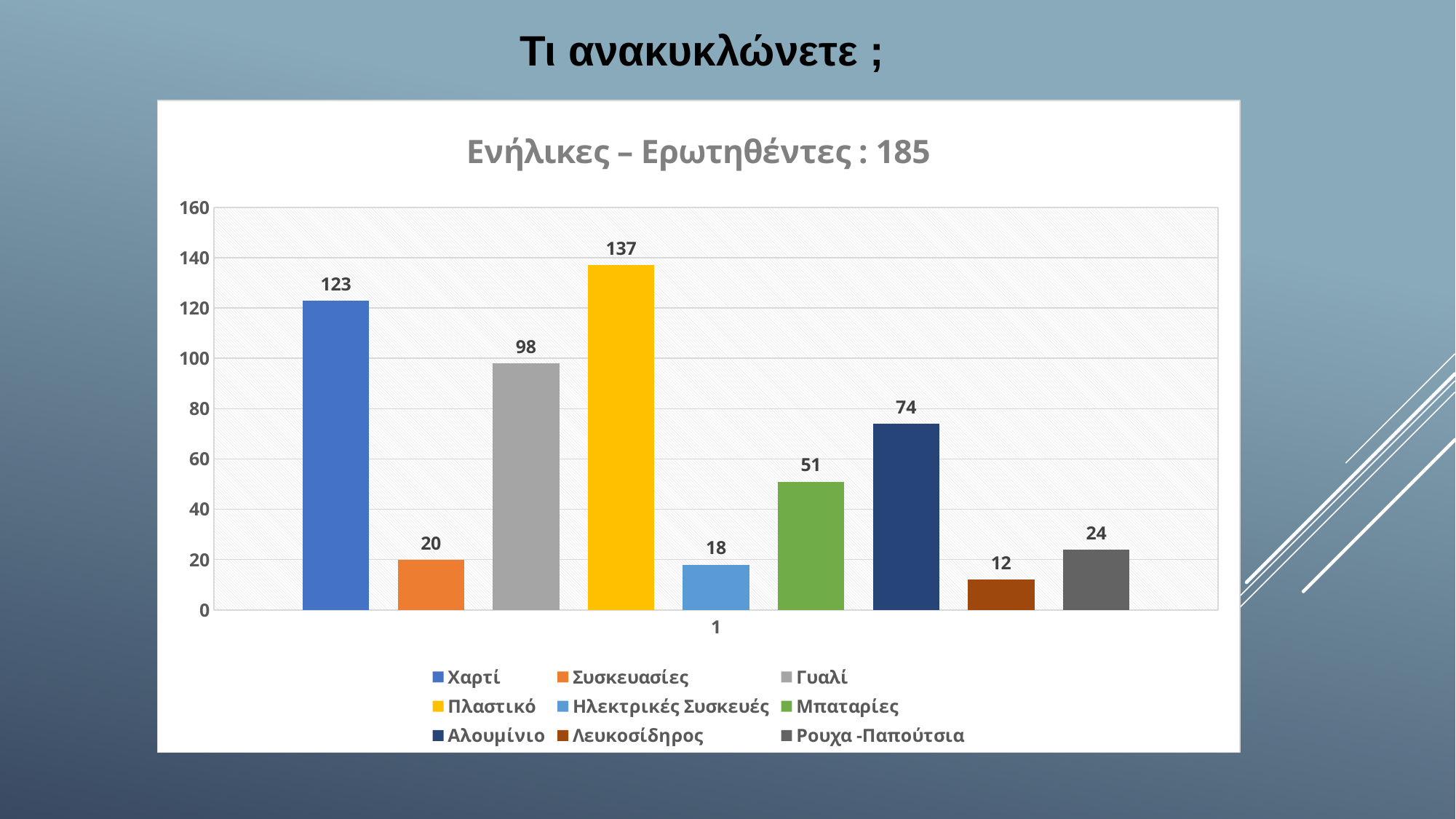
What is the value for Πλαστικό? 137 What is the title of the chart? Ενήλικες – Ερωτηθέντες : 185 Which series has the highest value? Πλαστικό What is the value for Λευκοσίδηρος? 12 What kind of chart is shown on the slide? Bar chart What is the difference between the values for Γυαλί and Μπαταρίες? 47 What is the value for Χαρτί? 123 Which is larger, the value for Συσκευασίες or the value for Ρουχα -Παπούτσια? Ρουχα -Παπούτσια What is the value for Αλουμίνιο? 74 What is the difference between the values for Πλαστικό and Χαρτί? 14 How many series does the legend list? 9 Which series has the lowest value? Λευκοσίδηρος